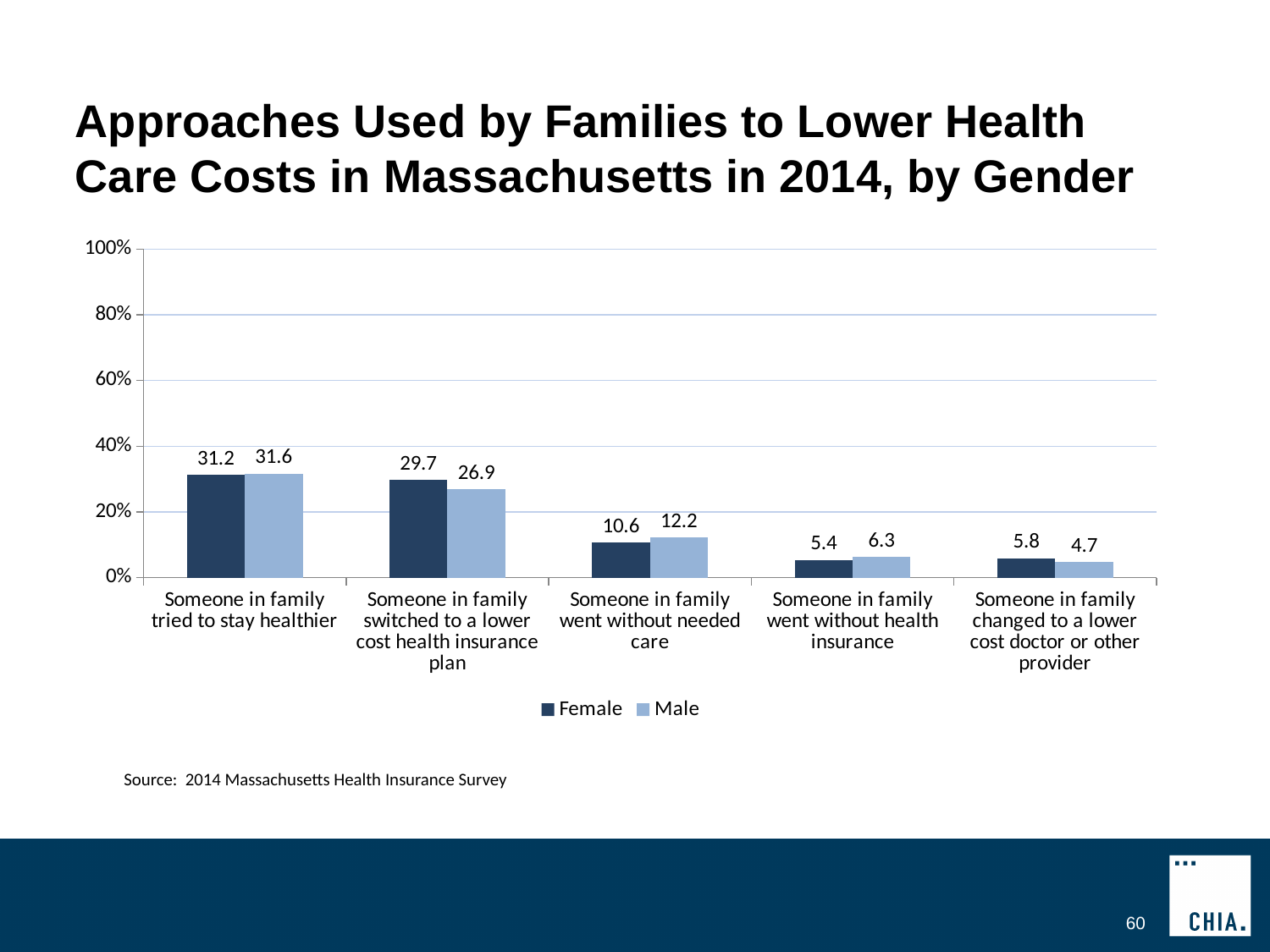
Is the Female value for "Someone in family tried to stay healthier" greater or less than 40%? less What is the difference between the Female and Male values for "Someone in family switched to a lower cost health insurance plan"? 2.8 What kind of chart is shown on the slide? bar chart For "Someone in family went without health insurance", which is larger, the Female or Male value? Male What is the Female value for "Someone in family changed to a lower cost doctor or other provider"? 5.8 Which category has the highest Male value? Someone in family tried to stay healthier Which category has the lowest Female value? Someone in family went without health insurance What is the Female value for "Someone in family tried to stay healthier"? 31.2 What is the Male value for "Someone in family went without needed care"? 12.2 How many categories are shown on the x axis? 5 How many series does the legend list? 2 What is the Male value for "Someone in family switched to a lower cost health insurance plan"? 26.9